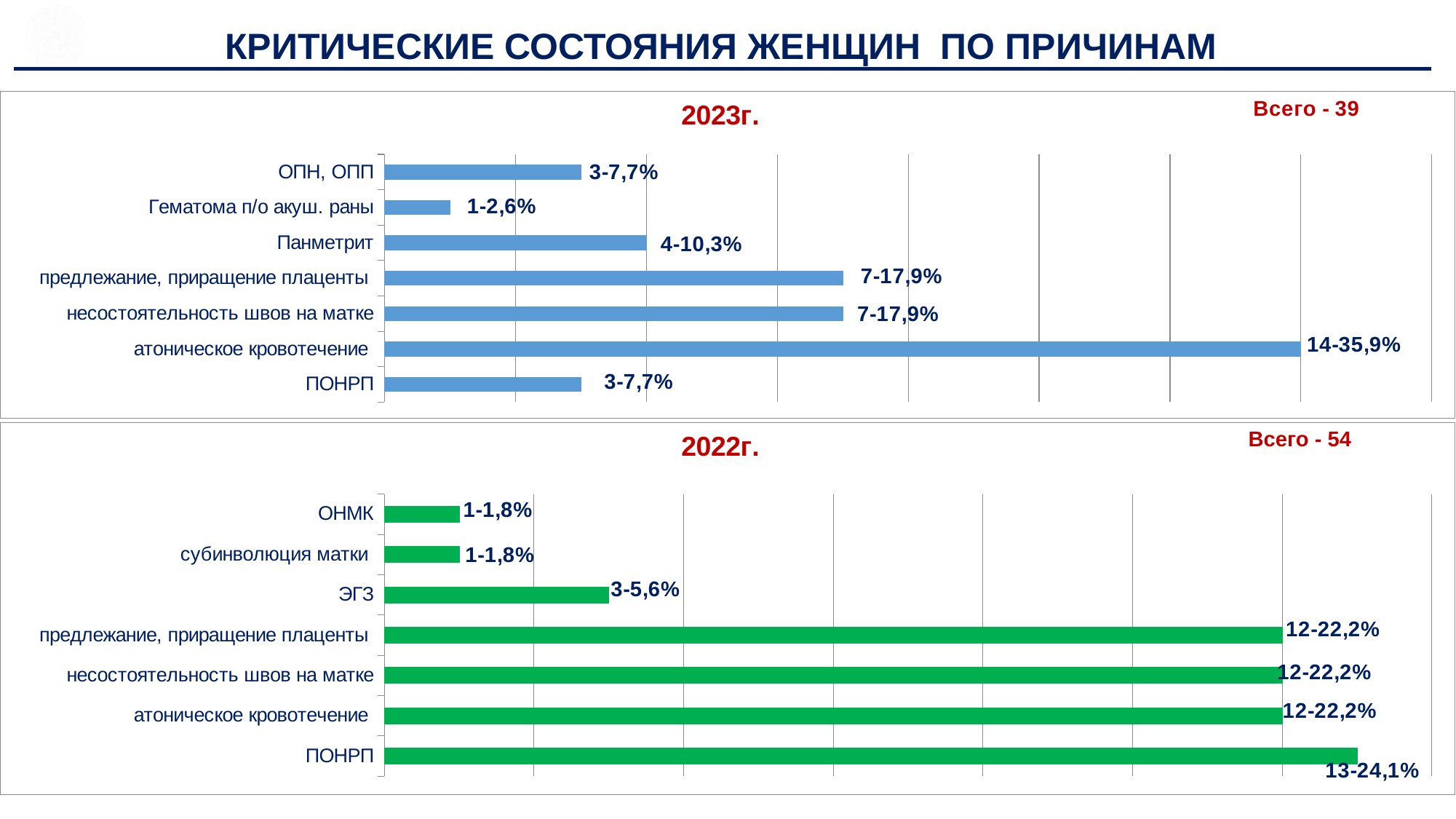
What total (Всего) is shown for the 2023г. chart? 39 In the 2023г. chart, which category has the highest value? атоническое кровотечение In the 2022г. chart, what is the data label for ЭГЗ? 3-5,6% In the 2022г. chart, which category has the highest value? ПОНРП In the 2022г. chart, what is the data label for ПОНРП? 13-24,1% What type of chart is the 2023г. chart? bar chart In the 2023г. chart, how many more cases does атоническое кровотечение have than Панметрит? 10 In the 2023г. chart, which category has the lowest value? Гематома п/о акуш. раны In the 2022г. chart, which is larger: the value for ЭГЗ or the value for ОНМК? ЭГЗ How many categories are shown in the 2022г. chart? 7 In the 2023г. chart, what is the data label for Панметрит? 4-10,3% In the 2023г. chart, what is the data label for атоническое кровотечение? 14-35,9%